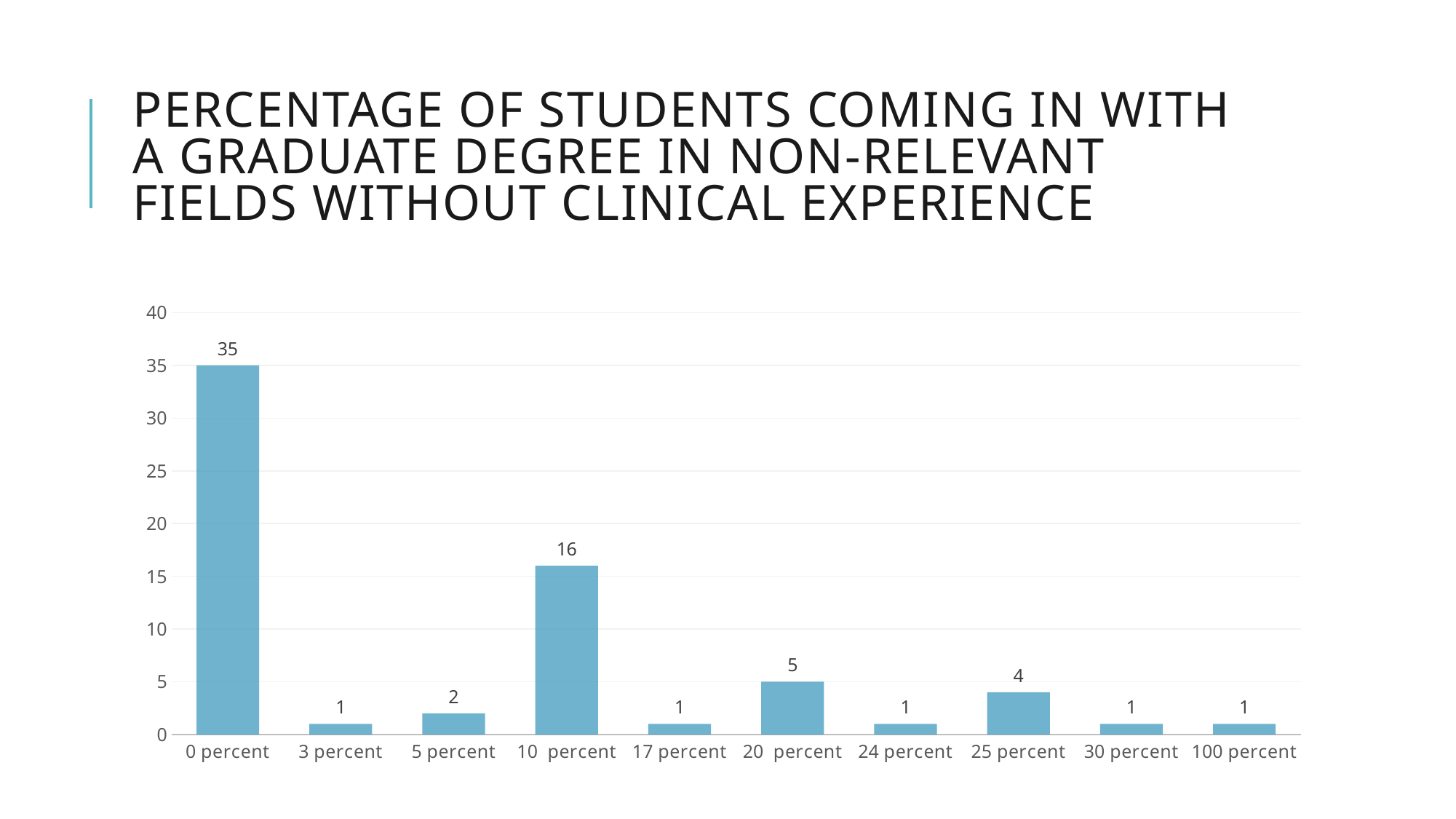
What is the difference between the values for "0 percent" and "10 percent"? 19 How many categories are shown on the x axis? 10 What is the value for the "10 percent" category? 16 Which category has the highest value? 0 percent Is the value for "10 percent" greater or less than 15? greater Which is larger, the value for "20 percent" or the value for "25 percent"? 20 percent What kind of chart is shown on the slide? bar chart What is the value for the "0 percent" category? 35 What is the value for the "5 percent" category? 2 What is the value for the "20 percent" category? 5 How many categories have a value of 1? 5 What is the value for the "25 percent" category? 4